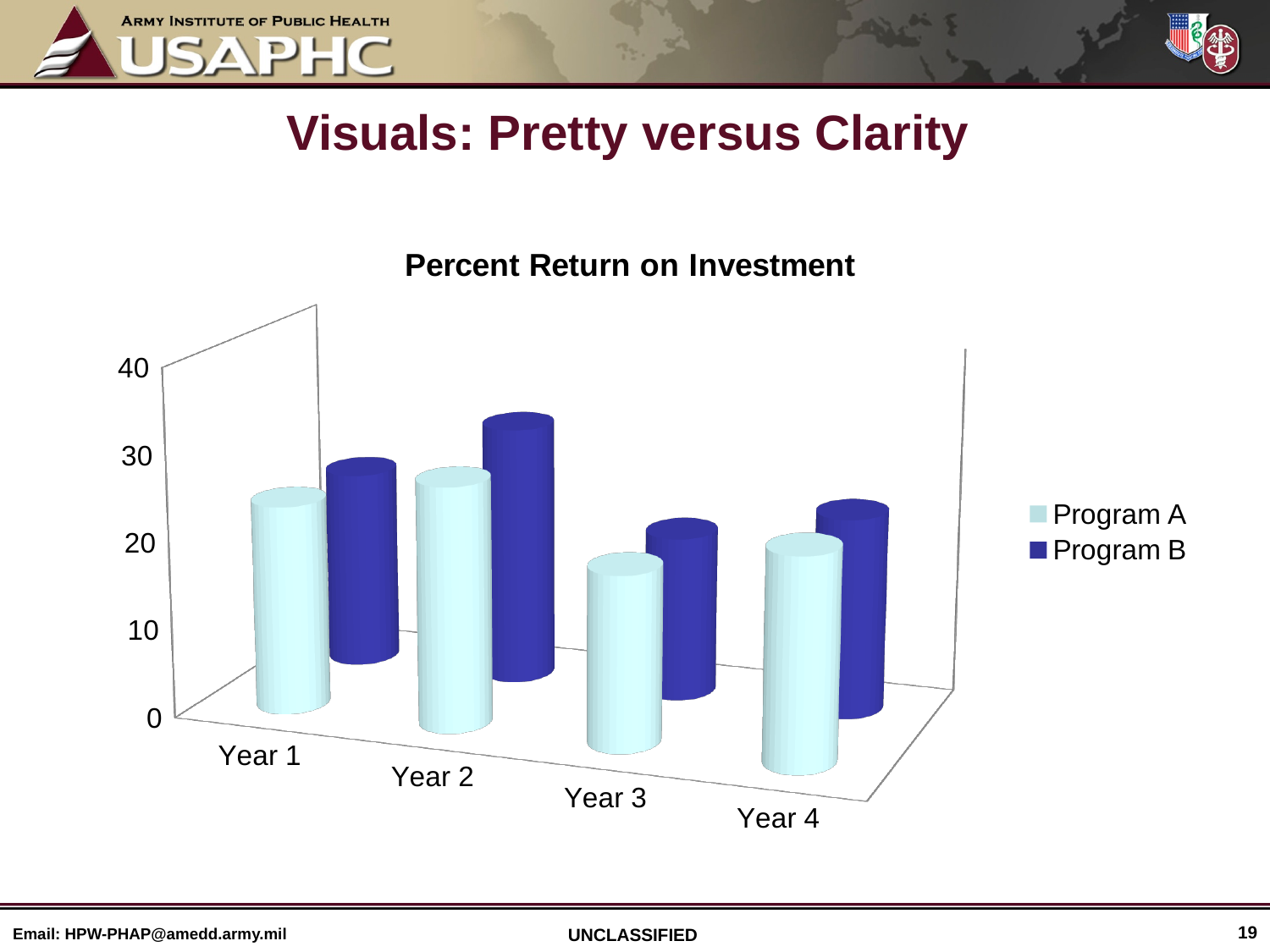
Which series is shown in dark blue? Program B What is the title of the chart? Percent Return on Investment Is the value for Program A in Year 3 greater or less than 30? less How many series does the legend list? 2 How many year categories are shown on the x axis? 4 Does the value for Program A rise or fall from Year 2 to Year 3? fall In which year does Program A have its highest value? Year 2 Is the value for Program A in Year 1 greater or less than 20? greater In which year does Program B reach its highest value? Year 2 What kind of chart is shown on the slide? bar chart Which is larger for Program B: the value in Year 1 or the value in Year 3? Year 1 Is the value for Program A in Year 2 greater or less than 20? greater